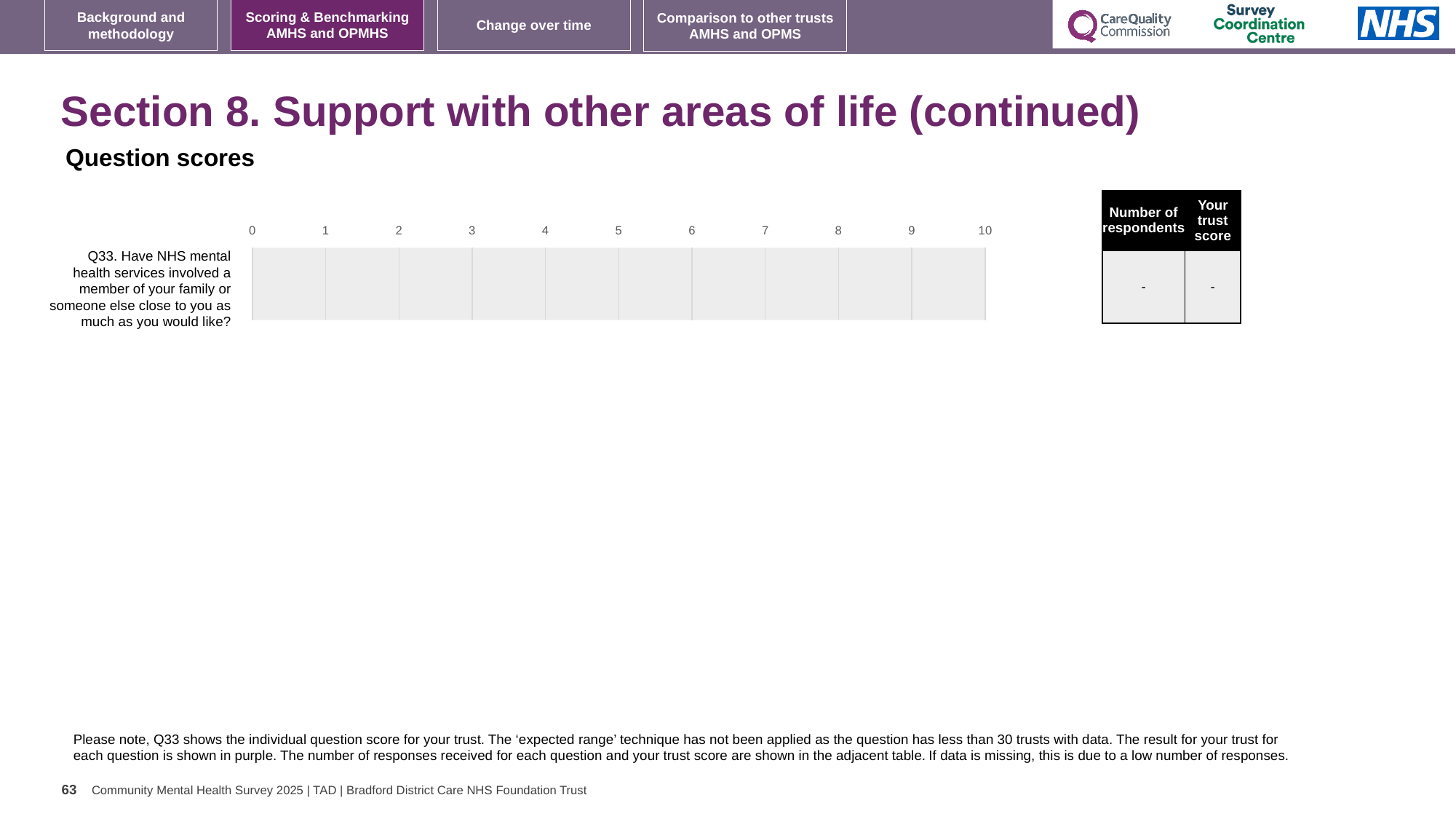
What is the highest value shown on the chart's horizontal axis? 10 According to the table next to the chart, what is the trust score for Q33? - According to the table next to the chart, what is the number of respondents for Q33? - How many questions (categories) are listed on the chart's vertical axis? 1 What kind of chart is shown on the slide? bar chart Which question number is shown on the chart? Q33 What is the lowest value shown on the chart's horizontal axis? 0 Is a bar plotted for Q33 on the chart? No